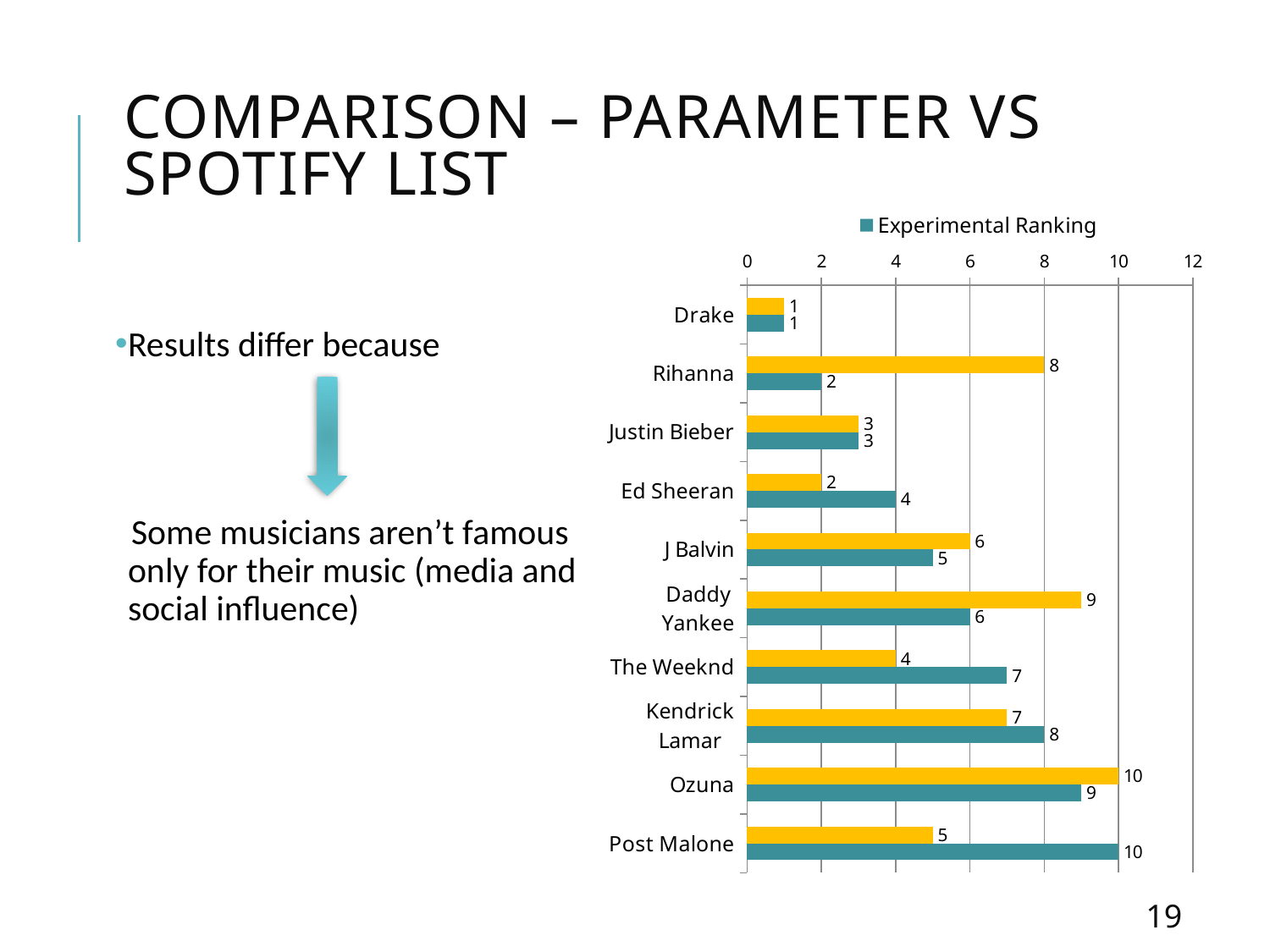
What series name is shown in the chart legend? Experimental Ranking Which musician has the highest Experimental Ranking value? Post Malone What kind of chart is shown on the slide? Bar chart What is the value of the yellow bar for The Weeknd? 4 What is the Experimental Ranking value for Rihanna? 2 What is the Experimental Ranking value for Post Malone? 10 What is the value of the yellow bar for Ozuna? 10 Do the Experimental Ranking values increase or decrease going down the chart from Drake to Post Malone? Increase Which musician has the lowest Experimental Ranking value? Drake For Ed Sheeran, which is larger: the Experimental Ranking bar or the yellow bar? Experimental Ranking bar What is the difference between the yellow bar and the Experimental Ranking bar for Rihanna? 6 How many musicians are listed on the chart? 10